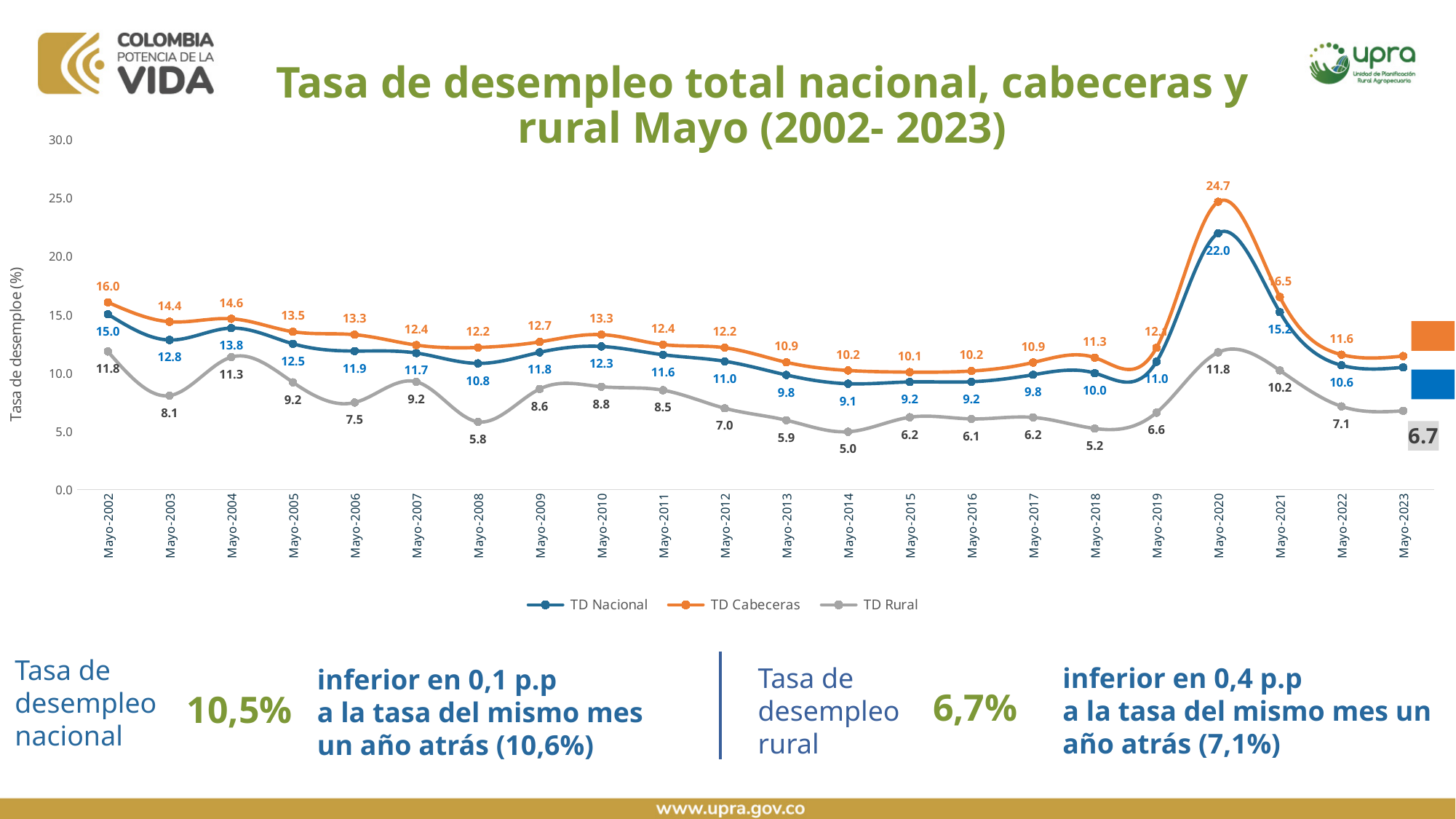
What is the value of TD Rural for Mayo-2023? 6.7 What is the value of TD Nacional for Mayo-2020? 22.0 What is the difference between TD Cabeceras and TD Nacional in Mayo-2020? 2.7 How many series does the legend list? 3 In which month-year does TD Cabeceras reach its highest value? Mayo-2020 What kind of chart is shown on the slide? line chart Which is larger for TD Rural: the value in Mayo-2002 or in Mayo-2003? Mayo-2002 Is the value of TD Cabeceras for Mayo-2020 greater or less than 20.0? greater What is the value of TD Nacional for Mayo-2014? 9.1 In which month-year does TD Rural reach its lowest value? Mayo-2014 What is the value of TD Cabeceras for Mayo-2020? 24.7 How many month-year points are plotted along the x axis? 22